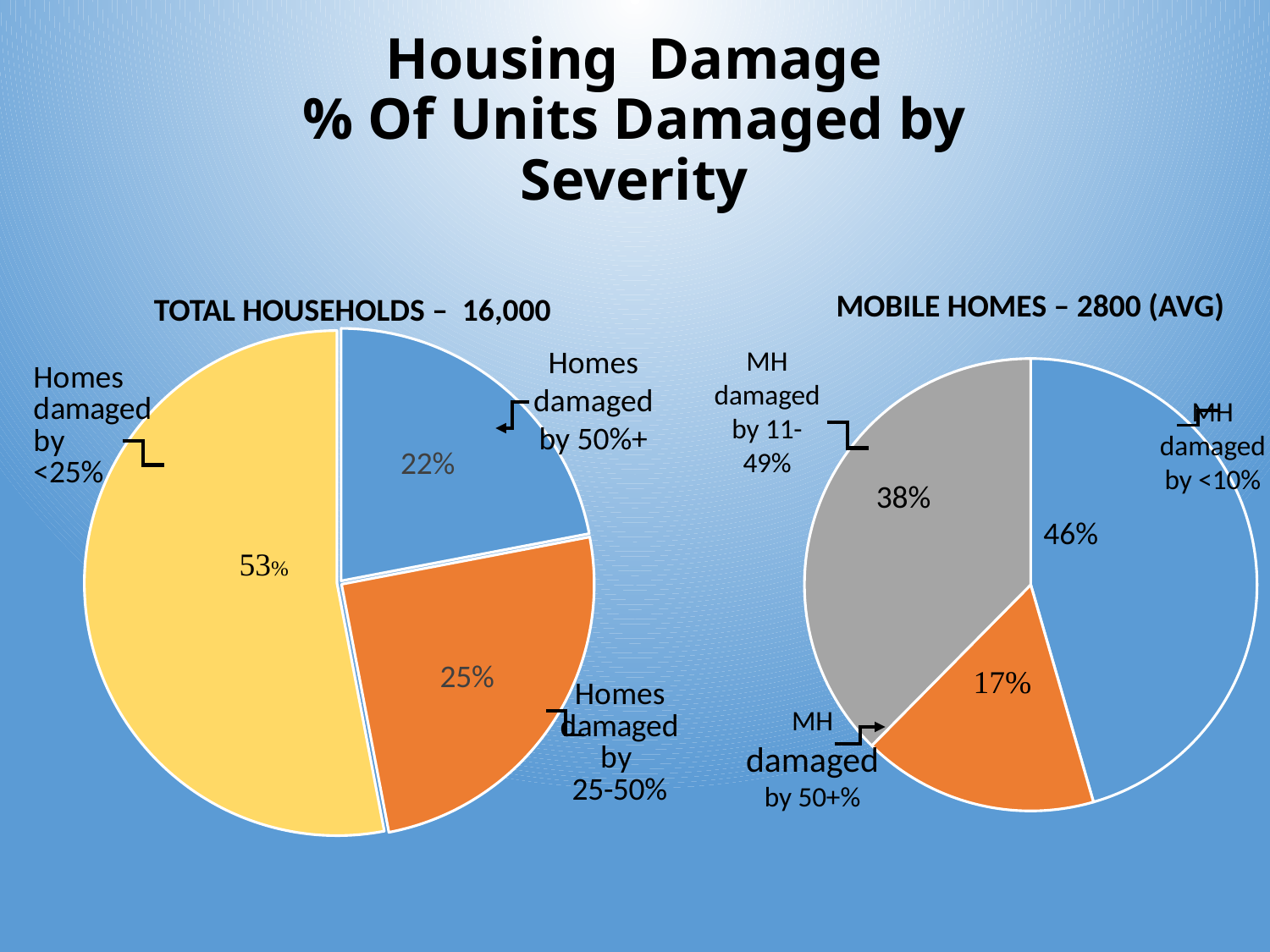
In the 'MOBILE HOMES – 2800 (AVG)' chart, which category has the smallest slice? MH damaged by 50+% In the 'TOTAL HOUSEHOLDS – 16,000' chart, which category has the largest slice? Homes damaged by <25% In the 'MOBILE HOMES – 2800 (AVG)' chart, what share of mobile homes were damaged by 50+%? 17% In the 'TOTAL HOUSEHOLDS – 16,000' chart, what share of homes were damaged by <25%? 53% In the 'TOTAL HOUSEHOLDS – 16,000' chart, what is the difference between the share of homes damaged by <25% and the share damaged by 50%+? 31% In the 'MOBILE HOMES – 2800 (AVG)' chart, which is larger: the share damaged by <10% or the share damaged by 11-49%? MH damaged by <10% In the 'MOBILE HOMES – 2800 (AVG)' chart, what share of mobile homes were damaged by 11-49%? 38% What type of chart is the 'TOTAL HOUSEHOLDS – 16,000' chart? Pie chart How many slices does the 'MOBILE HOMES – 2800 (AVG)' chart have? 3 In the 'MOBILE HOMES – 2800 (AVG)' chart, what share of mobile homes were damaged by <10%? 46% In the 'TOTAL HOUSEHOLDS – 16,000' chart, what share of homes were damaged by 25-50%? 25% In the 'TOTAL HOUSEHOLDS – 16,000' chart, what share of homes were damaged by 50%+? 22%